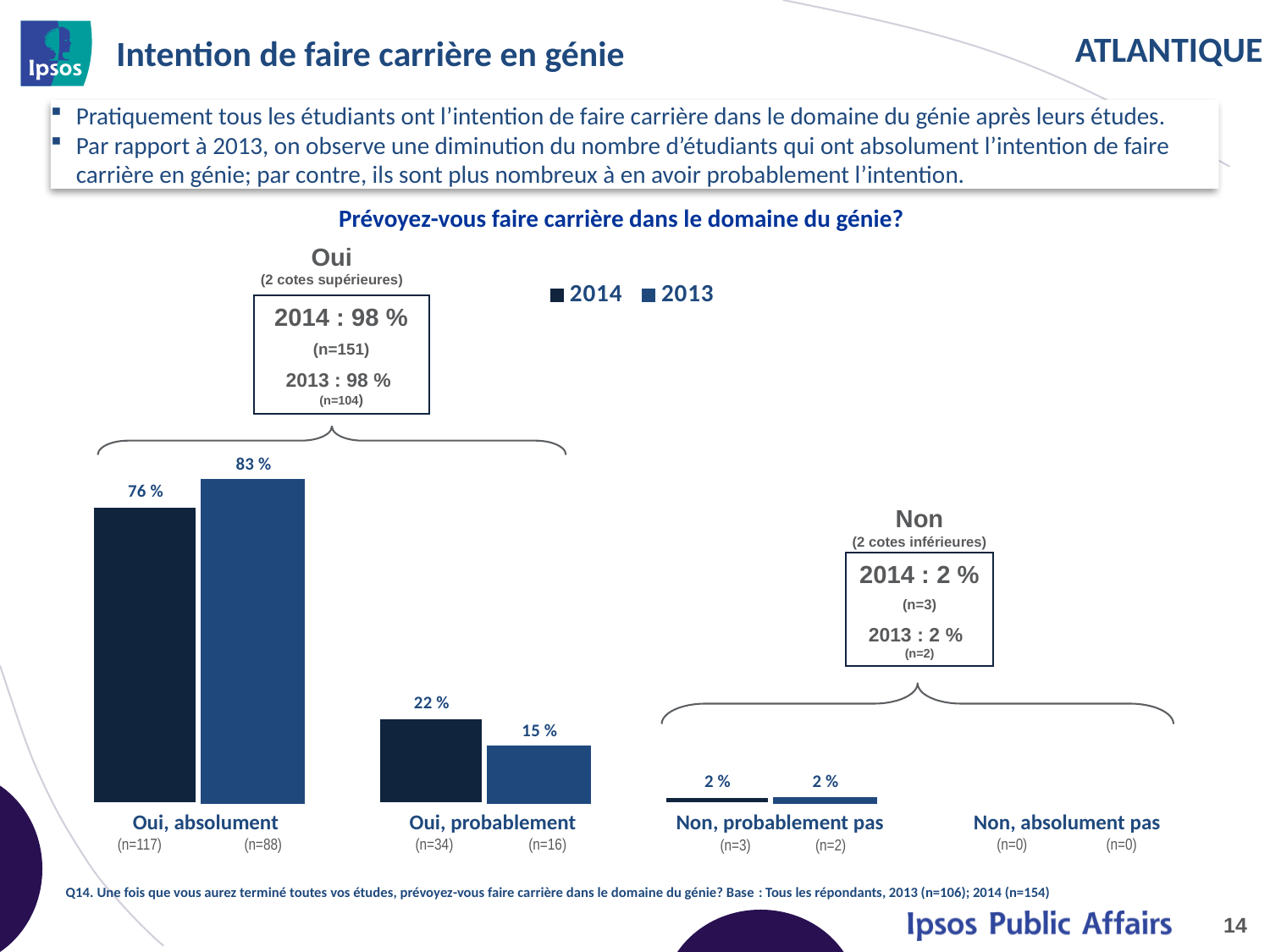
Which category has the highest value for the 2013 series? Oui, absolument What is the value for 2013 in the "Oui, probablement" category? 15 % What is the difference between the 2014 and 2013 values for "Oui, probablement"? 7 % What is the value for 2014 in the "Oui, probablement" category? 22 % How many series does the legend list? 2 What is the value for 2013 in the "Oui, absolument" category? 83 % What is the difference between the 2013 and 2014 values for "Oui, absolument"? 7 % What kind of chart is shown on the slide? Bar chart What is the value for 2014 in the "Oui, absolument" category? 76 % What is the value for 2014 in the "Non, probablement pas" category? 2 % What is the question shown as the chart title? Prévoyez-vous faire carrière dans le domaine du génie? Which is larger for "Oui, probablement": the 2014 value or the 2013 value? 2014